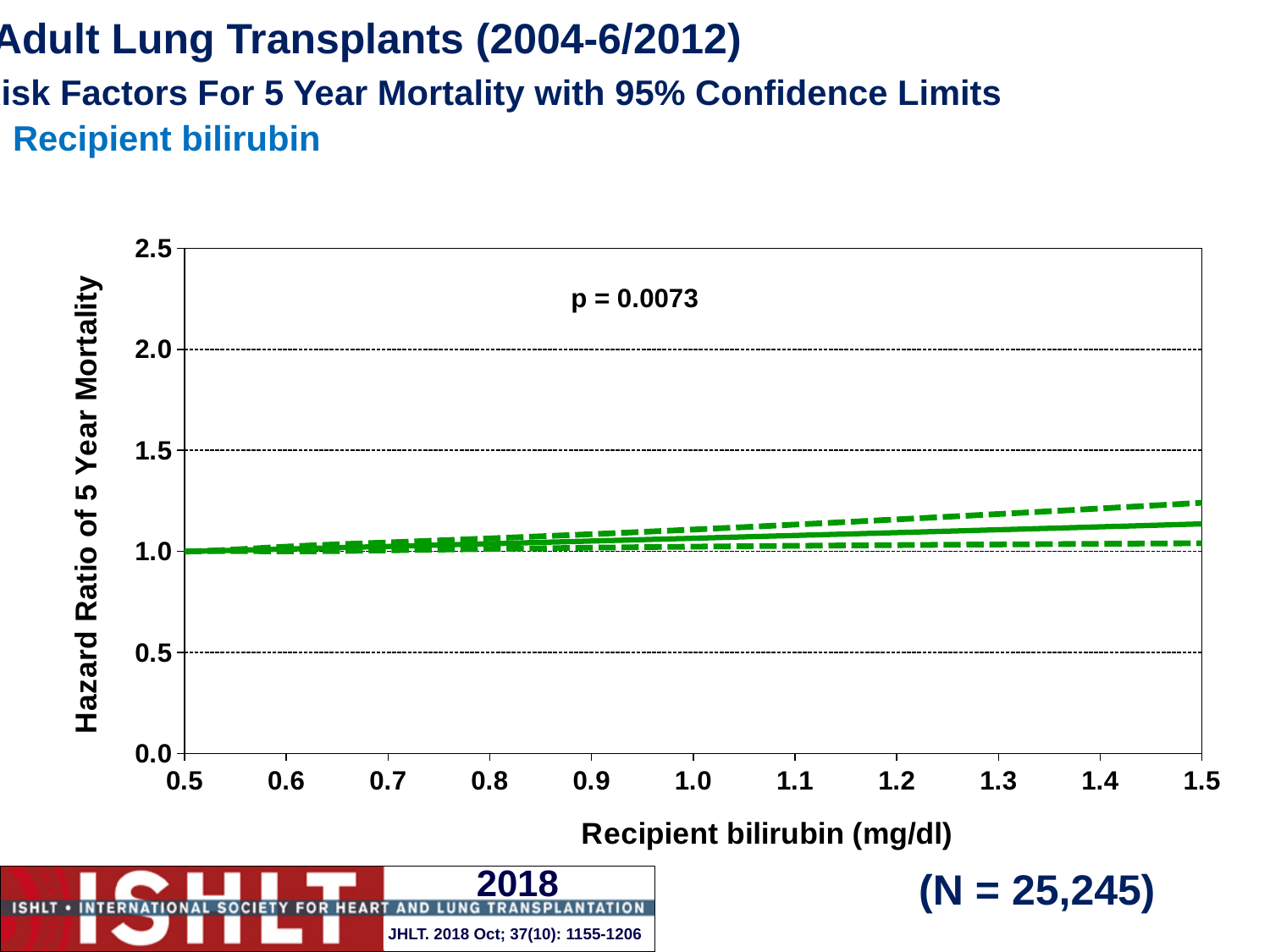
Is the hazard ratio at a recipient bilirubin of 1.5 mg/dl greater or less than 2.0? less What p-value is printed on the chart? p = 0.0073 What kind of chart is shown on the slide? line chart What is the highest value labelled on the y axis? 2.5 Is the hazard ratio at a recipient bilirubin of 1.5 mg/dl greater or less than 1.0? greater Is the hazard ratio at a recipient bilirubin of 0.5 mg/dl greater or less than 0.5? greater How many tick marks are labelled on the x axis? 11 Does the hazard ratio of 5 year mortality rise or fall as recipient bilirubin increases from 0.5 to 1.5 mg/dl? rise Which is larger, the hazard ratio at a recipient bilirubin of 1.5 mg/dl or at 0.5 mg/dl? 1.5 mg/dl